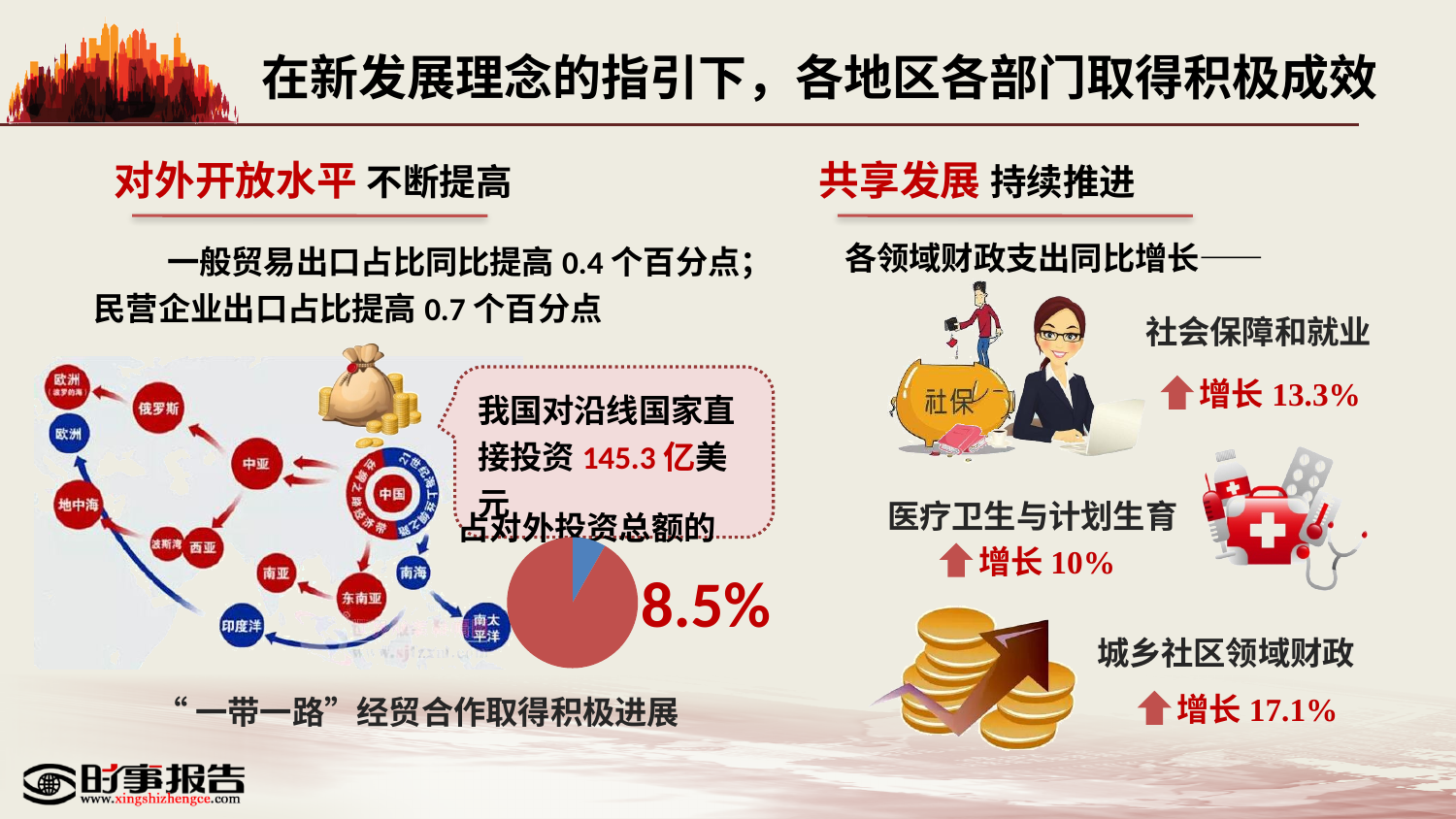
What share of total outward investment does the blue slice of the pie chart represent? 8.5% Which slice of the pie chart is larger, the blue one or the red one? the red one What share of the pie chart does the red slice represent? 91.5% What colour is the smaller slice of the pie chart? blue How many slices does the pie chart have? 2 According to the text next to the pie chart, what does the 8.5% figure represent? 占对外投资总额的 (share of total outward investment) What kind of chart is shown on the slide? pie chart